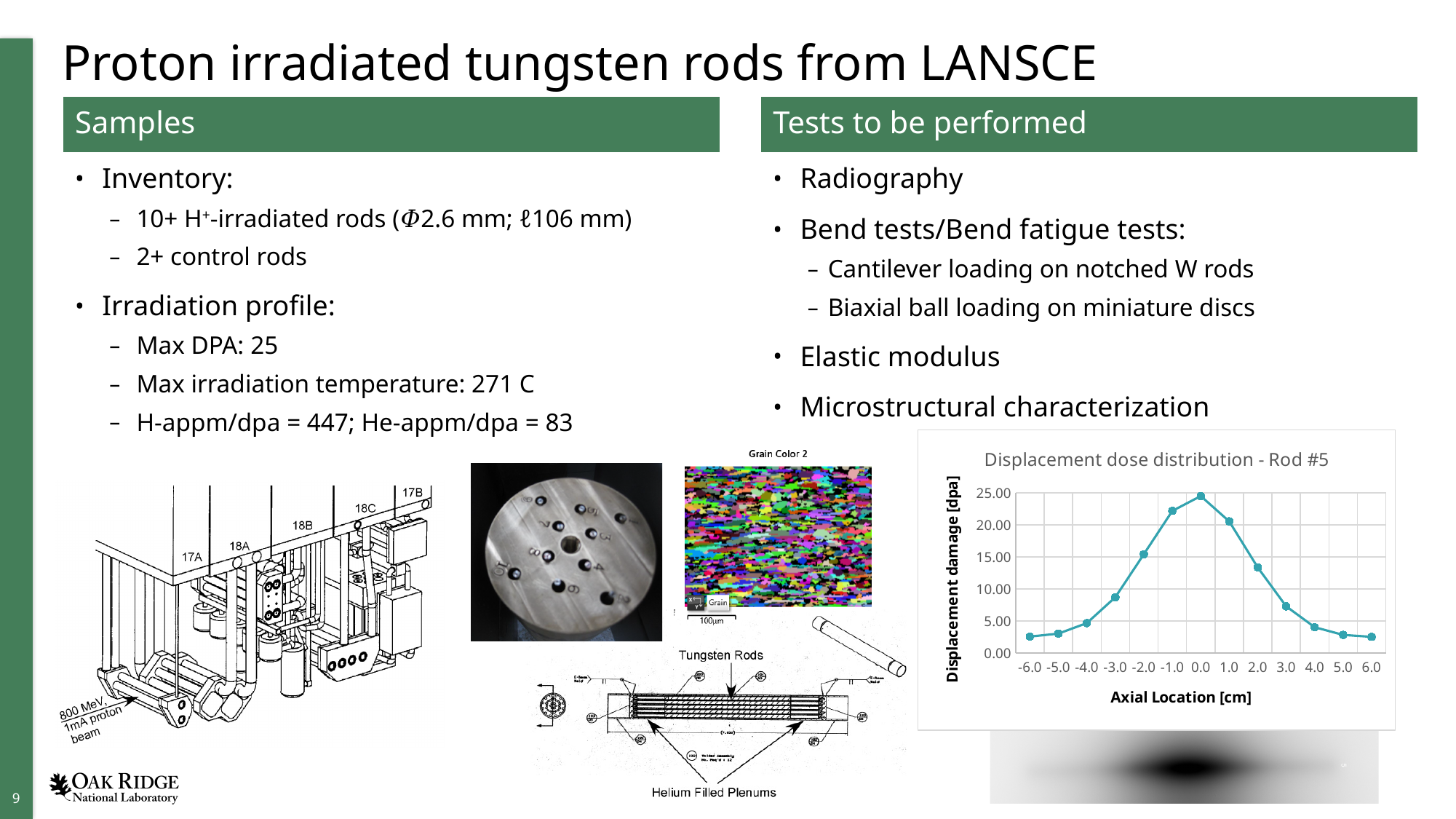
How many data points are plotted in the 'Displacement dose distribution - Rod #5' chart? 13 What is the title of the chart on the slide? Displacement dose distribution - Rod #5 In the 'Displacement dose distribution - Rod #5' chart, is the value at axial location 3.0 greater or less than 10.00? less In the 'Displacement dose distribution - Rod #5' chart, do the values rise or fall as the axial location goes from -6.0 to 0.0? rise In the 'Displacement dose distribution - Rod #5' chart, do the values rise or fall as the axial location goes from 0.0 to 6.0? fall At which axial location is the displacement damage highest in the 'Displacement dose distribution - Rod #5' chart? 0.0 In the 'Displacement dose distribution - Rod #5' chart, is the value at axial location 0.0 greater or less than 20.00? greater What kind of chart is the 'Displacement dose distribution - Rod #5' chart? line chart In the 'Displacement dose distribution - Rod #5' chart, which has the larger displacement damage: axial location 0.0 or axial location 4.0? 0.0 What is the x-axis label of the 'Displacement dose distribution - Rod #5' chart? Axial Location [cm] In the 'Displacement dose distribution - Rod #5' chart, is the value at axial location 2.0 greater or less than 10.00? greater